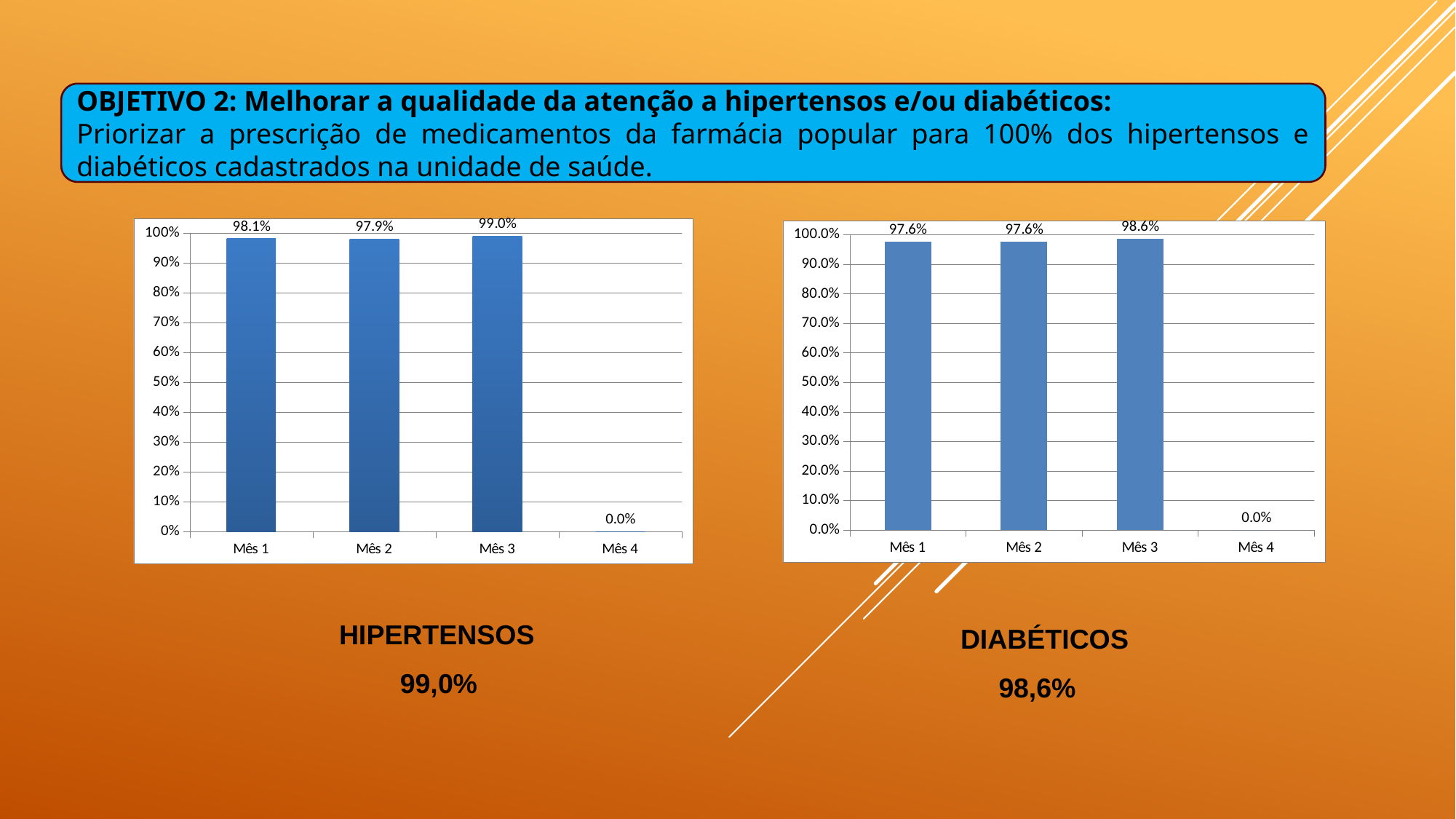
In the left chart (HIPERTENSOS), what is the difference between the values for Mês 3 and Mês 2? 1.1 percentage points In the left chart (HIPERTENSOS), which is larger, the value for Mês 1 or Mês 2? Mês 1 In the left chart (HIPERTENSOS), which month has the highest value? Mês 3 In the right chart (DIABÉTICOS), which month has the lowest value? Mês 4 In the left chart (HIPERTENSOS), what is the value for Mês 2? 97.9% What type of chart is the right chart (DIABÉTICOS)? bar chart In the right chart (DIABÉTICOS), what is the value for Mês 3? 98.6% In the right chart (DIABÉTICOS), what is the difference between the values for Mês 3 and Mês 1? 1.0 percentage points In the left chart (HIPERTENSOS), what is the value for Mês 1? 98.1% How many months are shown on the x axis of the left chart (HIPERTENSOS)? 4 In the right chart (DIABÉTICOS), is the value for Mês 2 greater or less than 90.0%? greater In the right chart (DIABÉTICOS), what is the value for Mês 4? 0.0%